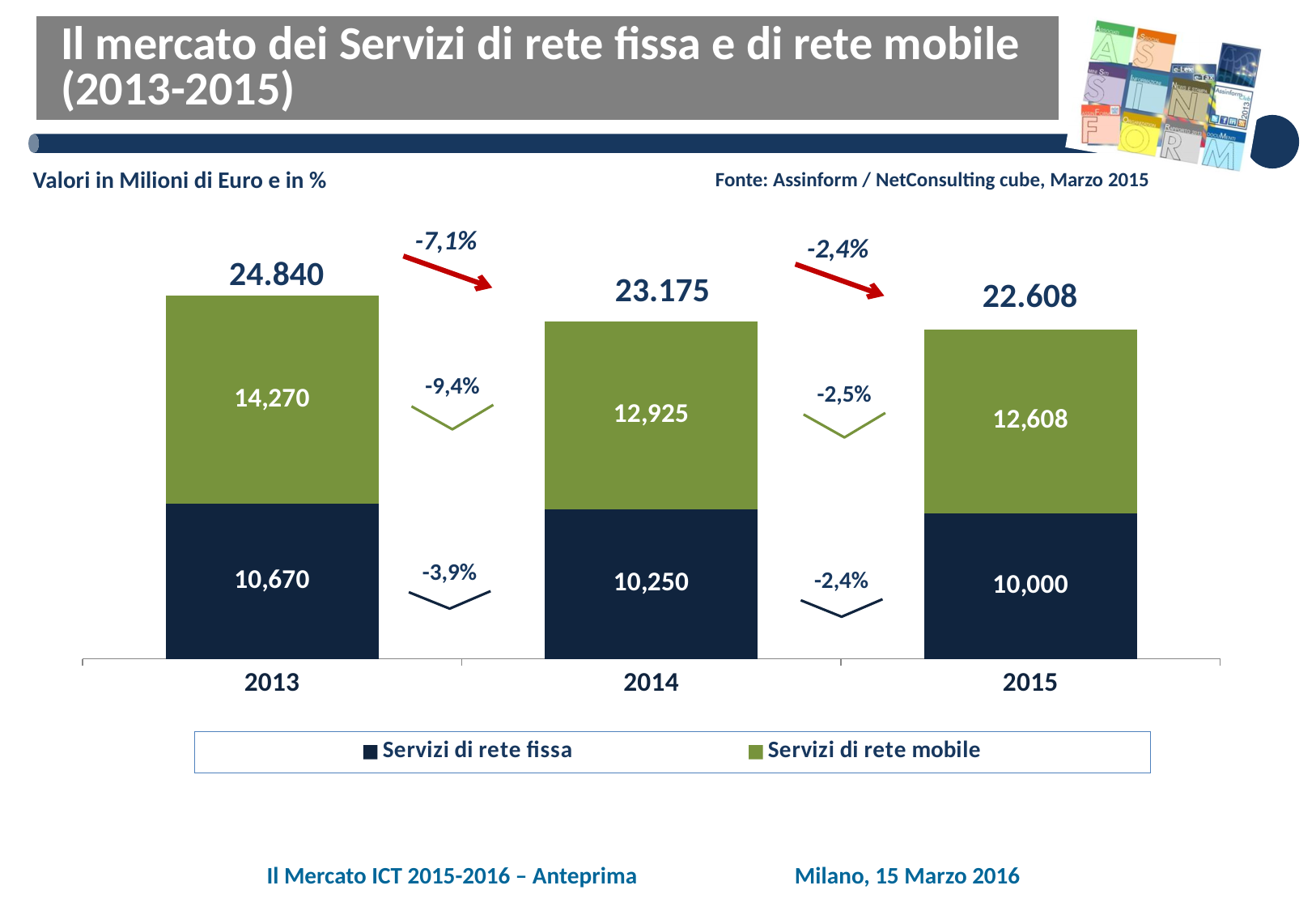
Which year has the lowest value for Servizi di rete fissa? 2015 Which year has the highest total value? 2013 What is the total value shown above the 2014 bar? 23.175 Do the total values rise or fall from 2013 to 2015? fall What percentage change is shown for Servizi di rete mobile between 2014 and 2015? -2,5% In 2014, which is larger: Servizi di rete fissa or Servizi di rete mobile? Servizi di rete mobile How many years are shown on the x axis? 3 What percentage change is shown for the total between 2013 and 2014? -7,1% What is the difference between the Servizi di rete mobile value in 2013 and in 2014? 1,345 What is the value for Servizi di rete mobile in 2015? 12,608 How many series does the legend list? 2 What is the value for Servizi di rete fissa in 2013? 10,670